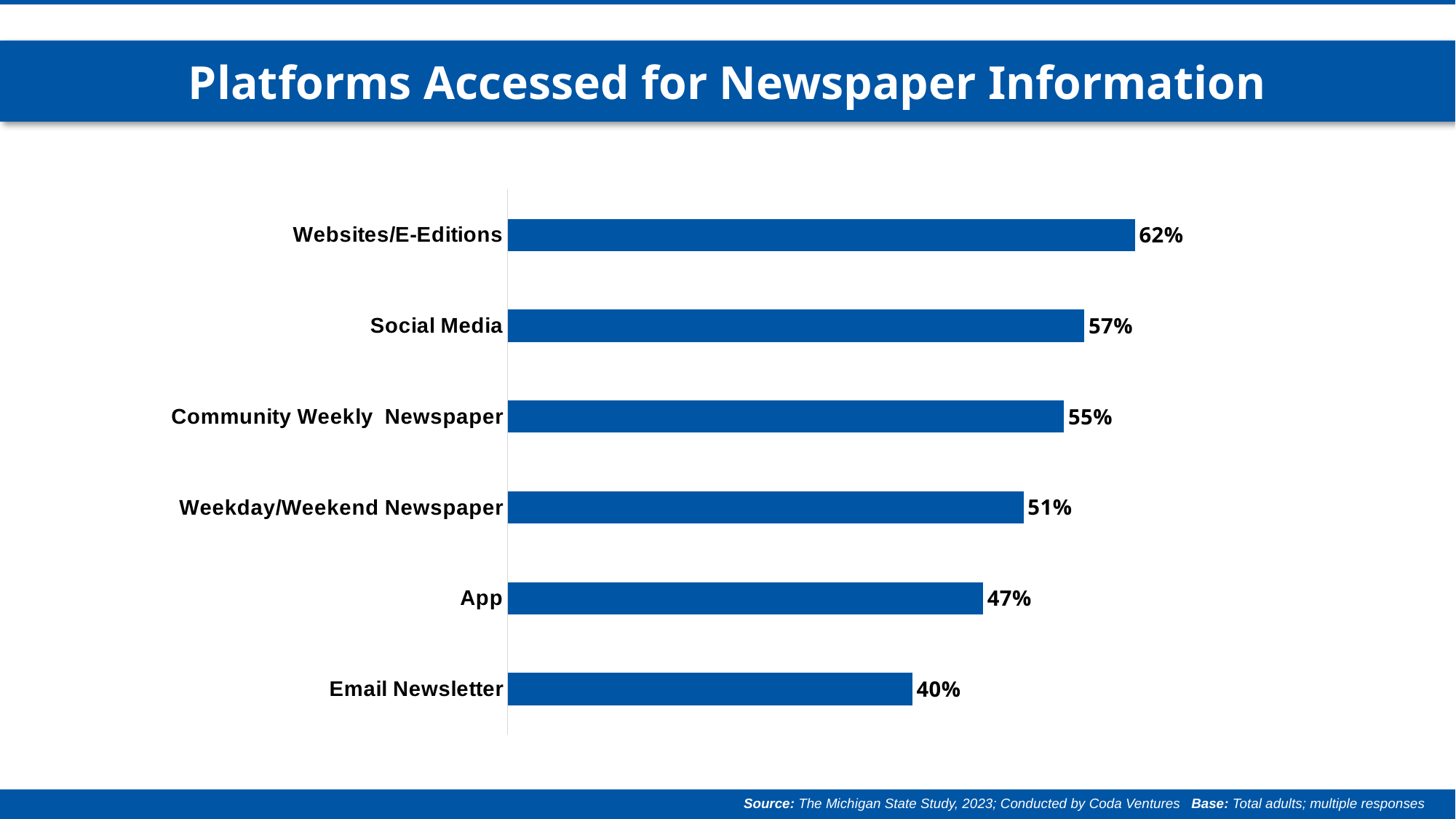
Which platform has the lowest value? Email Newsletter What is the value shown for Social Media? 57% What is the value shown for App? 47% What is the difference between the values for Social Media and Community Weekly Newspaper? 2% Which has a larger value, Weekday/Weekend Newspaper or App? Weekday/Weekend Newspaper Which platform has the highest value? Websites/E-Editions What is the value shown for Email Newsletter? 40% What percentage of adults accessed Websites/E-Editions for newspaper information? 62% What is the title of the chart? Platforms Accessed for Newspaper Information How many platforms are shown in the chart? 6 What kind of chart is shown on the slide? Bar chart What is the difference between the values for Websites/E-Editions and Email Newsletter? 22%